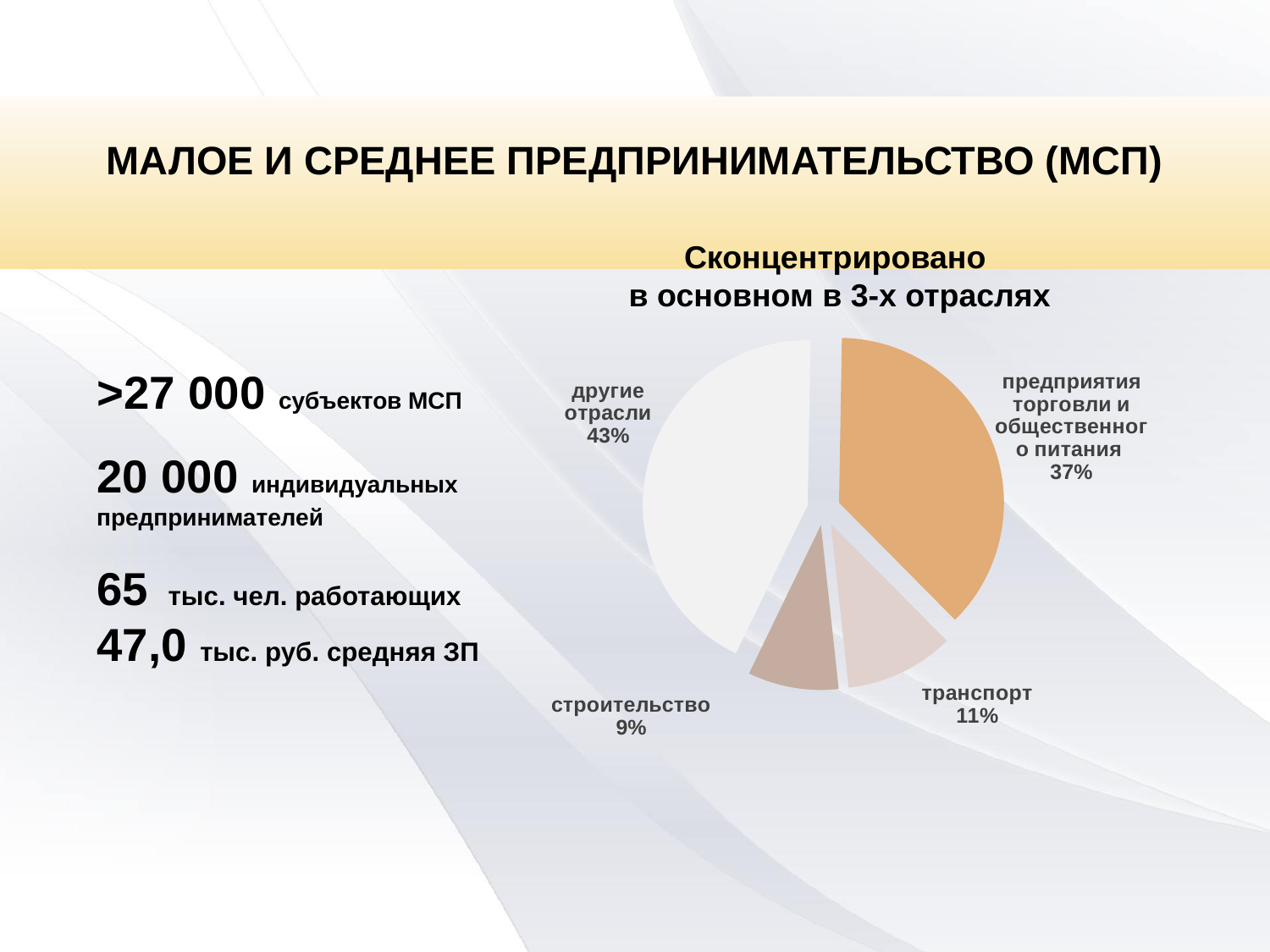
Which is larger: the share of 'транспорт' or the share of 'строительство'? транспорт What is the title of the chart? Сконцентрировано в основном в 3-х отраслях What kind of chart is shown on the slide? pie chart What is the difference between the shares of 'другие отрасли' and 'предприятия торговли и общественного питания'? 6% Which slice of the pie is the largest? другие отрасли What share of the pie does 'другие отрасли' hold? 43% What share of the pie does 'предприятия торговли и общественного питания' hold? 37% Which slice of the pie is the smallest? строительство What is the value shown for 'строительство'? 9% What is the difference between the shares of 'транспорт' and 'строительство'? 2% How many slices does the pie chart have? 4 What is the value shown for 'транспорт'? 11%